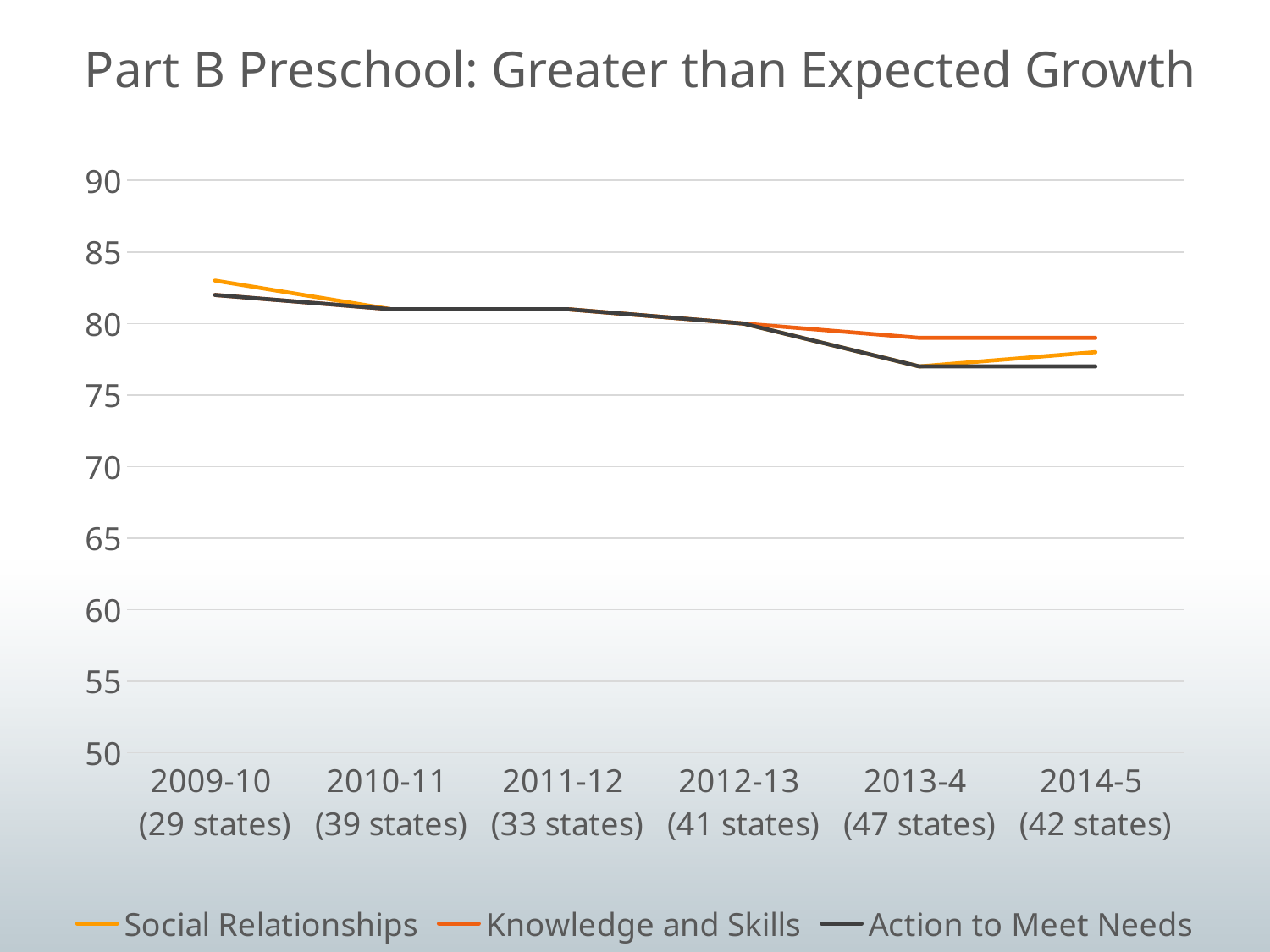
Do the values for Action to Meet Needs generally rise or fall from 2009-10 to 2014-5? fall What is the title of the chart? Part B Preschool: Greater than Expected Growth In 2013-4, which is higher: Knowledge and Skills or Action to Meet Needs? Knowledge and Skills Is the value for Social Relationships in 2009-10 greater or less than 80? greater Is the value for Knowledge and Skills in 2014-5 greater or less than 75? greater Is the value for Action to Meet Needs in 2013-4 greater or less than 80? less How many states are noted for the 2013-4 period on the x axis? 47 states How many time periods are plotted along the x axis? 6 How many series does the legend list? 3 In 2014-5, which is higher: Knowledge and Skills or Action to Meet Needs? Knowledge and Skills What kind of chart is shown on the slide? line chart